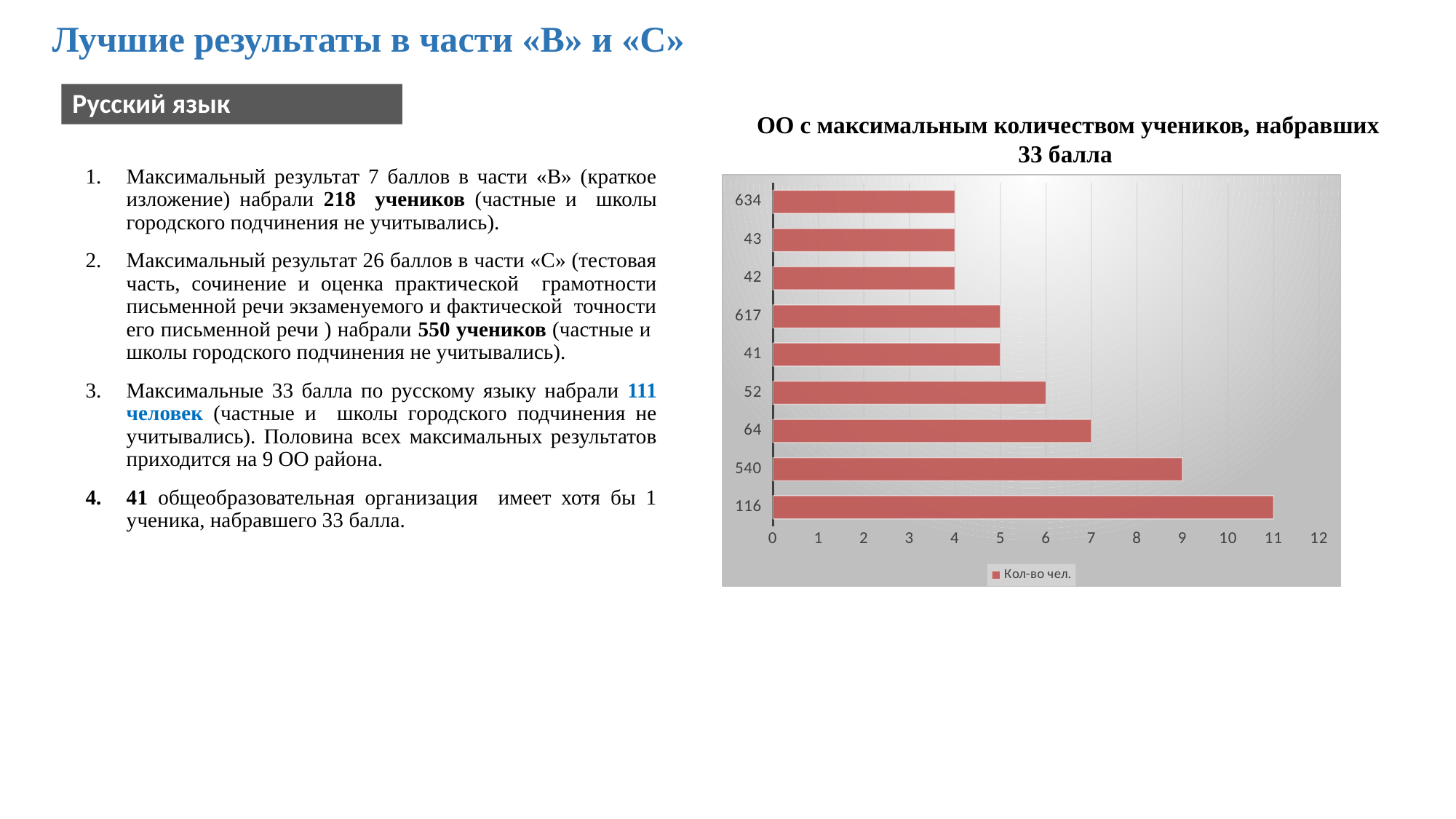
What type of chart is shown on the slide? bar chart What is the value for school 617? 5 What is the value for school 116? 11 Which has a larger value, school 540 or school 64? 540 How many categories (schools) are shown in the chart? 9 What is the value for school 540? 9 Is the value for school 116 greater or less than 10? greater What is the difference between the values for school 116 and school 540? 2 Which school has the highest number of students with 33 points? 116 What is the value for school 64? 7 What is the name of the series in the chart legend? Кол-во чел. How many series does the chart legend list? 1